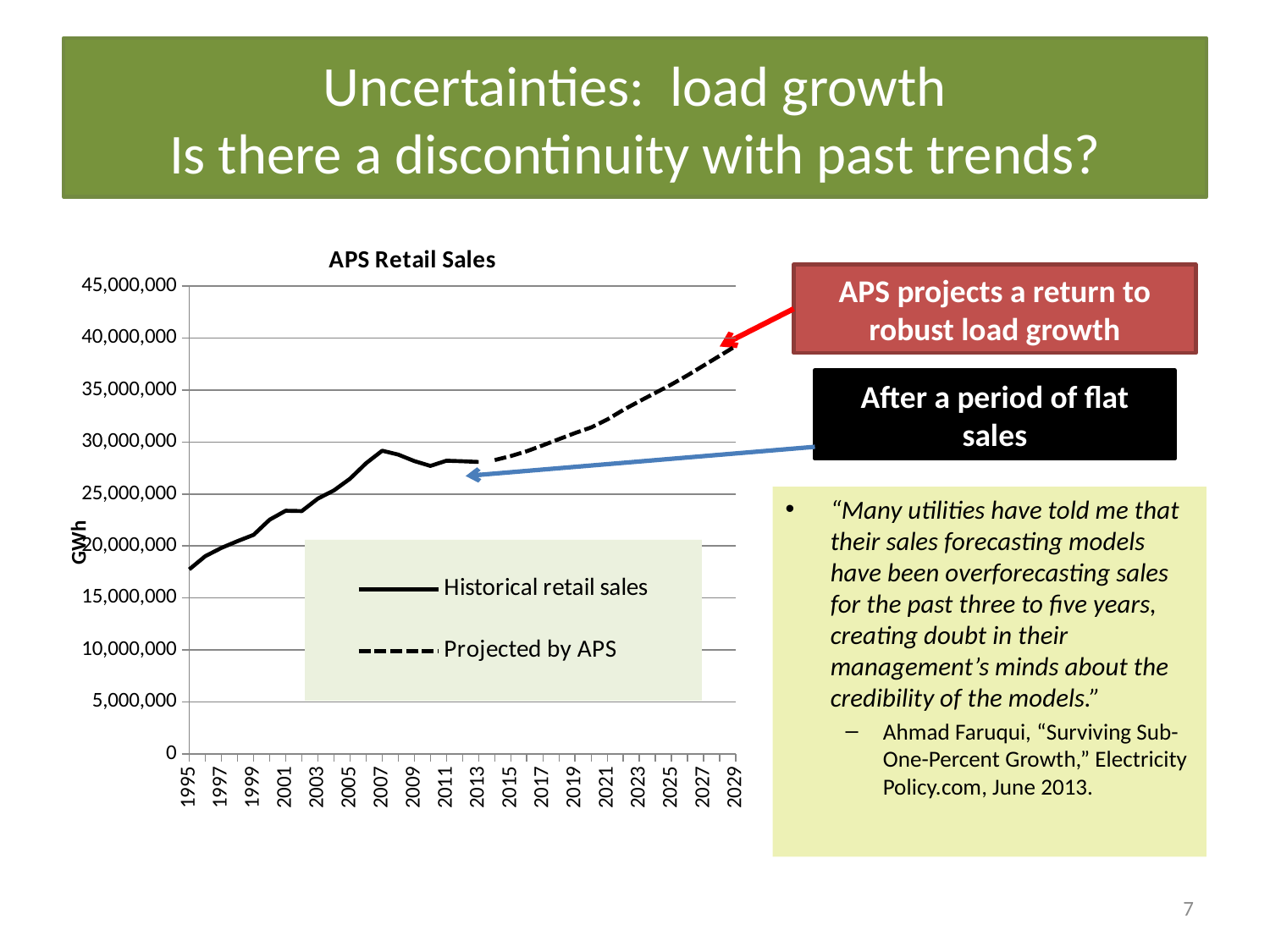
What kind of chart is shown on the slide? line chart How many series does the chart legend list? 2 What unit is shown on the chart's vertical axis label? GWh Is the historical retail sales value for 1995 greater or less than 20,000,000? less Is the projected by APS value for 2029 greater or less than 35,000,000? greater Do the historical retail sales rise or fall between 1995 and 2007? rise Which is larger: the projected value for 2029 or the historical value for 2013? projected value for 2029 Is the historical retail sales value for 2007 greater or less than 25,000,000? greater In which year do the historical retail sales reach their highest point? 2007 What is the title of the chart? APS Retail Sales